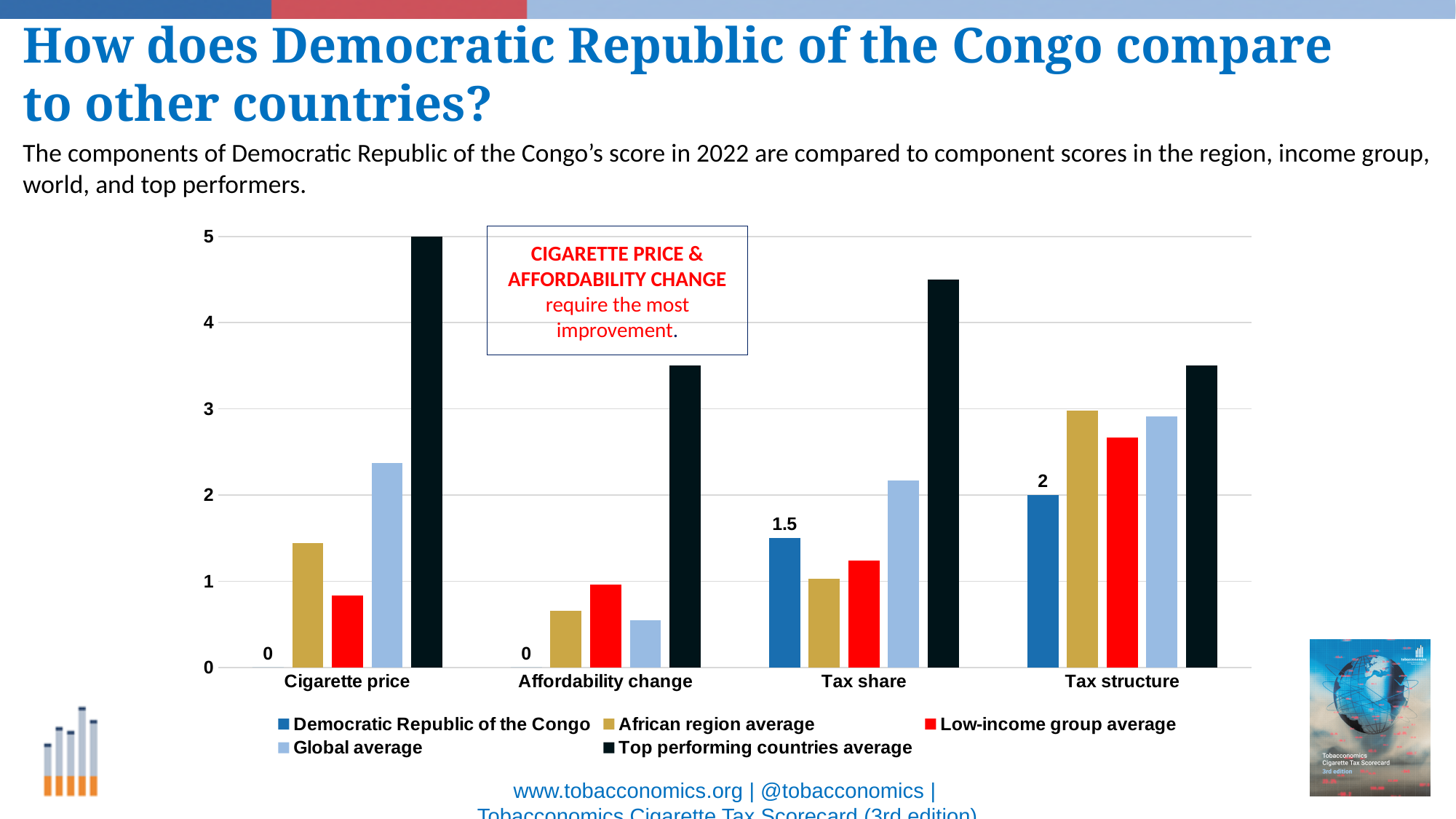
What is the value for Democratic Republic of the Congo in the Tax structure category? 2 What is the Top performing countries average value for Cigarette price? 5 What is the value for Democratic Republic of the Congo in the Cigarette price category? 0 What is the value for Democratic Republic of the Congo in the Tax share category? 1.5 For Cigarette price, which is larger: the Top performing countries average or the Global average? Top performing countries average In which category does Democratic Republic of the Congo have its highest value? Tax structure What type of chart is shown on the slide? bar chart How many categories are shown on the x axis of the chart? 4 Is the Global average value for Cigarette price greater or less than 2? greater How many series does the chart's legend list? 5 Is the Top performing countries average value for Tax share greater or less than 4? greater What is the difference between Democratic Republic of the Congo's Tax structure value and its Tax share value? 0.5